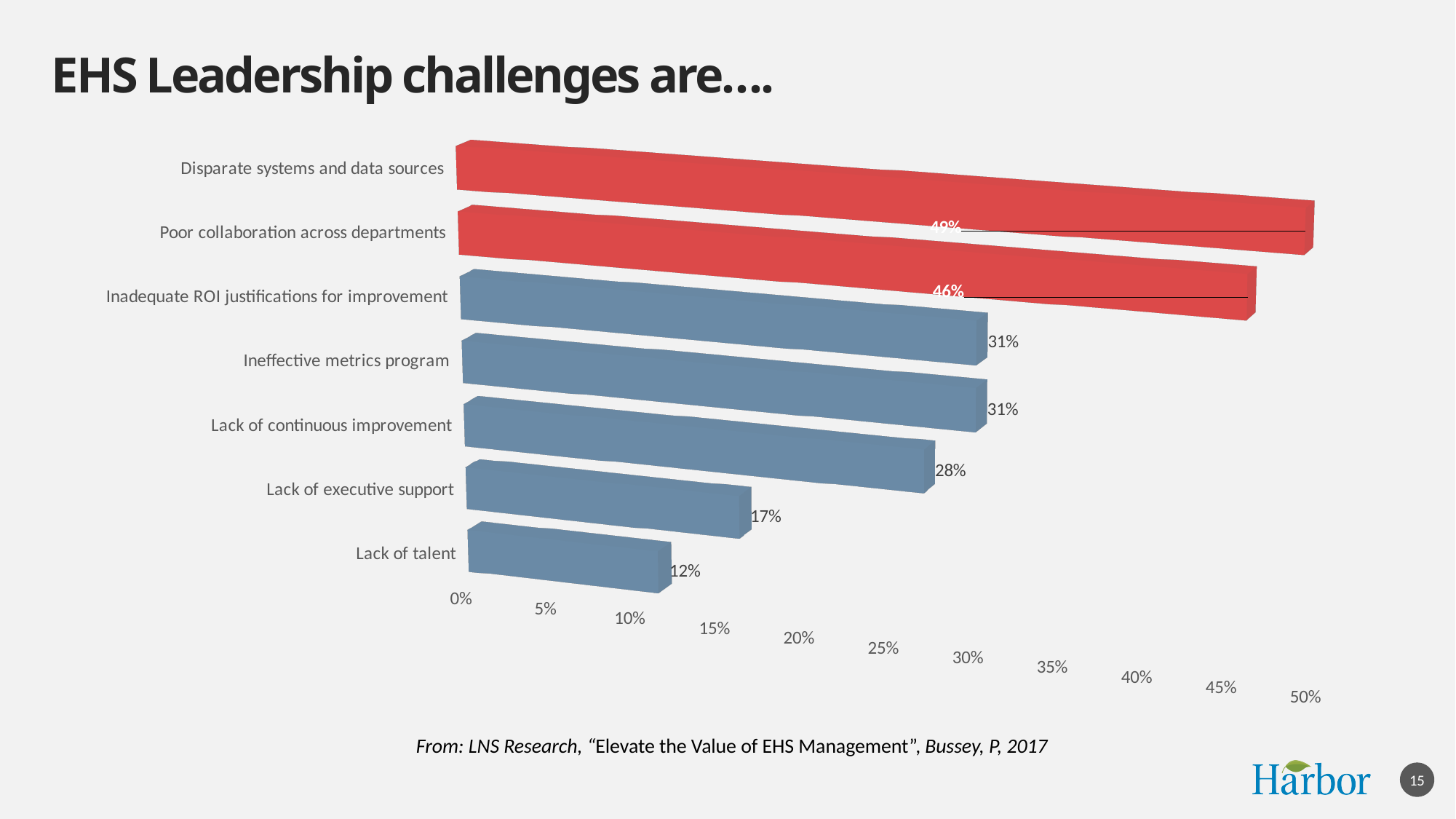
Which category has the lowest value? Lack of talent What is the difference between Lack of continuous improvement and Lack of executive support? 11% How many categories are shown in the chart? 7 What kind of chart is shown on the slide? Bar chart What is the value for Lack of executive support? 17% What is the value for Inadequate ROI justifications for improvement? 31% Which category has the highest value? Disparate systems and data sources Which is larger, Lack of executive support or Lack of talent? Lack of executive support Is the value for Disparate systems and data sources greater or less than 45%? greater What is the value for Lack of talent? 12% What is the value for Lack of continuous improvement? 28% What is the value for Poor collaboration across departments? 46%